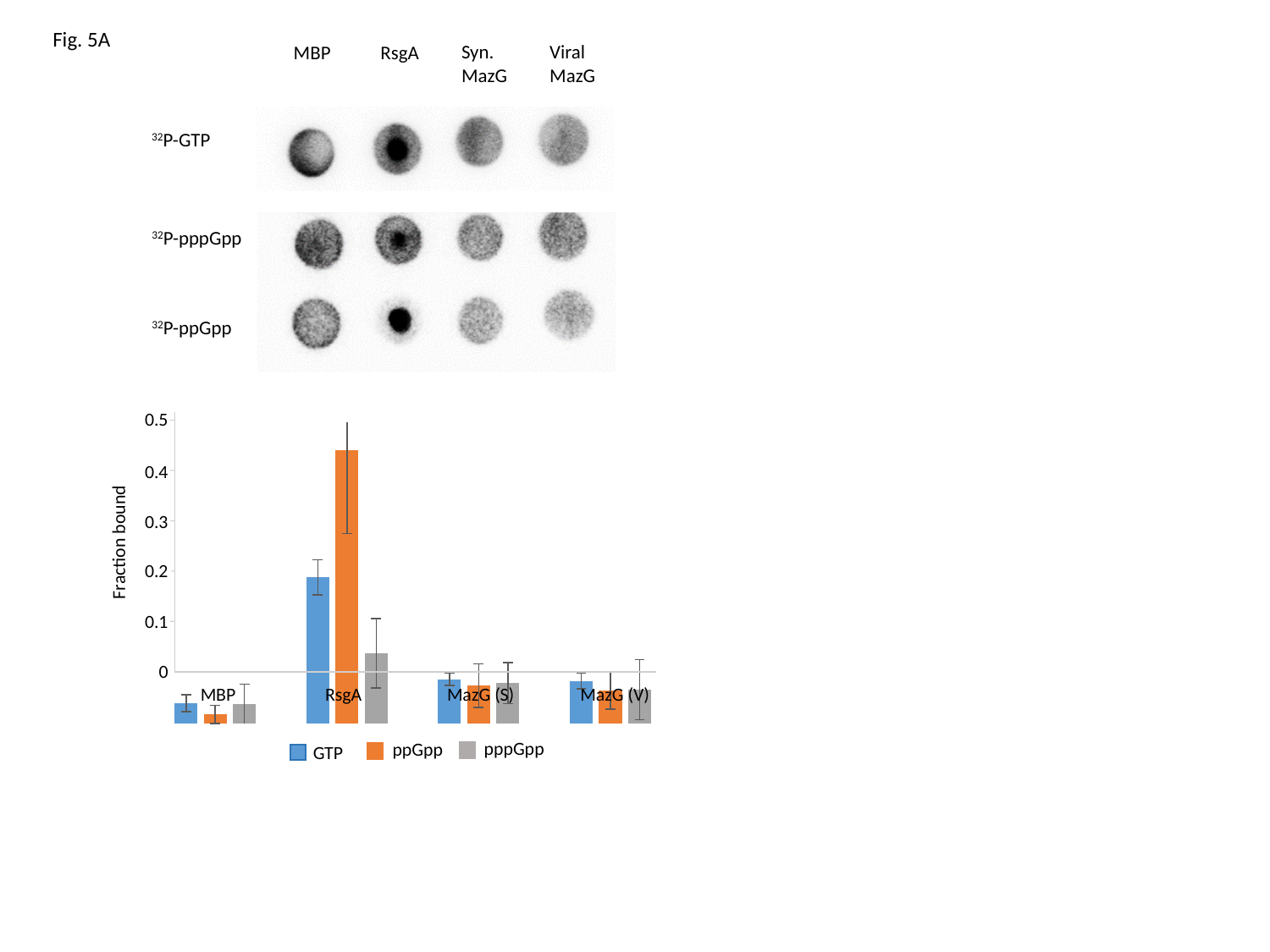
Which series has the highest value for RsgA? ppGpp What is the label of the y axis of the bar chart? Fraction bound For RsgA, which is larger: the ppGpp value or the GTP value? ppGpp Which series are listed in the legend of the bar chart? GTP, ppGpp, pppGpp How many series does the legend of the bar chart list? 3 Is the GTP value for RsgA greater or less than 0.1? greater Is the ppGpp value for RsgA greater or less than 0.4? greater What kind of chart is shown on the slide? bar chart How many categories are shown on the x axis of the bar chart? 4 Is the pppGpp value for RsgA greater or less than 0.1? less Which category has the highest bar in the chart? RsgA